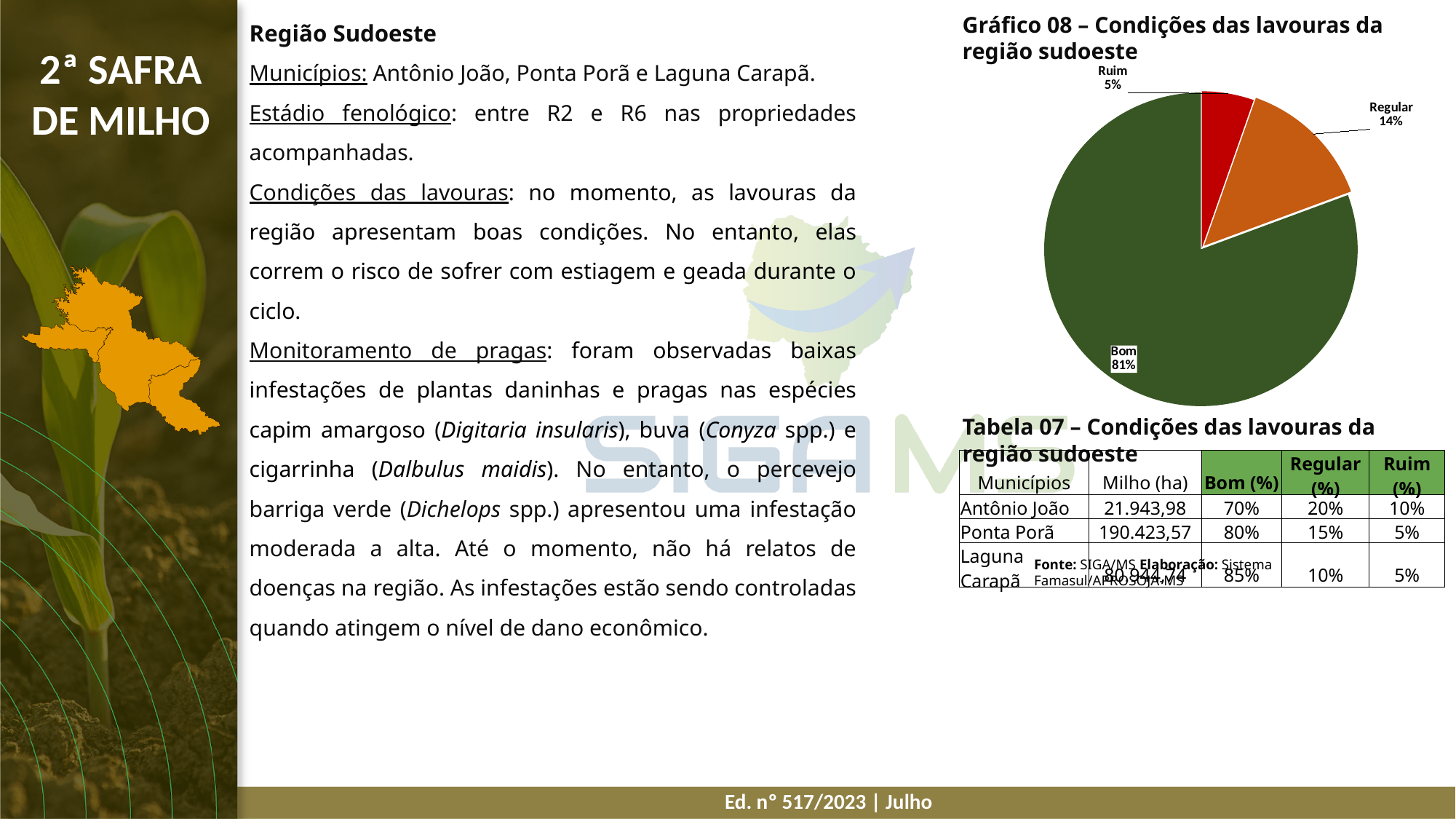
What is the share of the Regular slice in the pie chart? 14% What is the difference in percentage points between the Bom and Regular slices? 67 What colour is the Bom slice in the pie chart? dark green Which category has the largest slice in the pie chart? Bom Which category has the smallest slice in the pie chart? Ruim Which slice is larger in the pie chart, Regular or Ruim? Regular What is the title of the pie chart? Gráfico 08 – Condições das lavouras da região sudoeste What kind of chart is Gráfico 08? pie chart What is the share of the Bom slice in the pie chart? 81% How many slices does the pie chart have? 3 What is the difference in percentage points between the Regular and Ruim slices? 9 What is the share of the Ruim slice in the pie chart? 5%